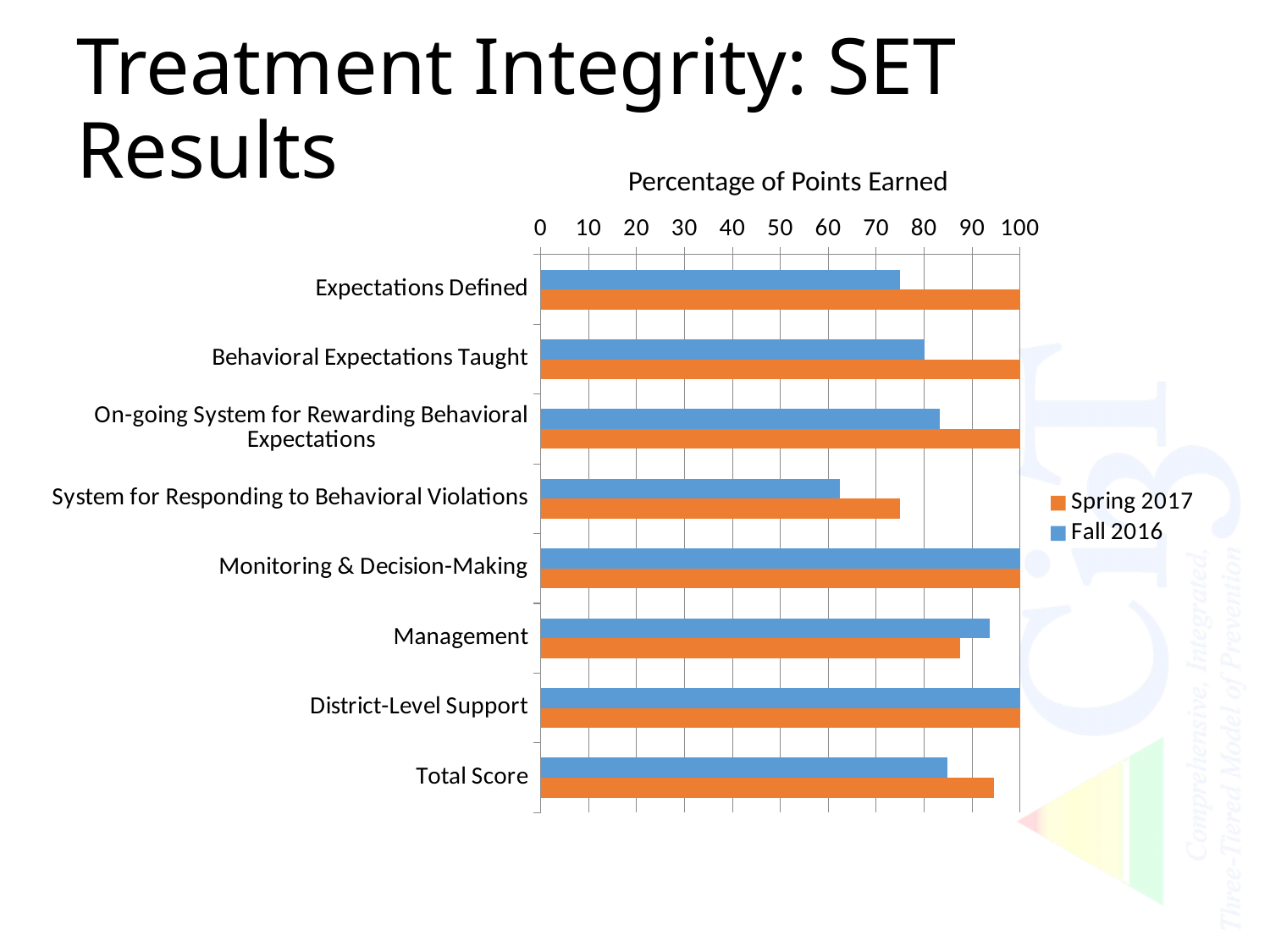
For Management, which series has the larger value, Spring 2017 or Fall 2016? Fall 2016 Is the Spring 2017 value for Management greater or less than 90? less What is the Fall 2016 value for Behavioral Expectations Taught? 80 What is the title of the chart? Percentage of Points Earned Which category has the lowest Spring 2017 value? System for Responding to Behavioral Violations What is the Spring 2017 value for Expectations Defined? 100 How many series does the legend list? 2 How many categories are shown on the chart? 8 Which category has the lowest Fall 2016 value? System for Responding to Behavioral Violations Is the Fall 2016 value for System for Responding to Behavioral Violations greater or less than 70? less What is the difference between the Spring 2017 and Fall 2016 values for Behavioral Expectations Taught? 20 Is the Fall 2016 value for Total Score greater or less than 80? greater